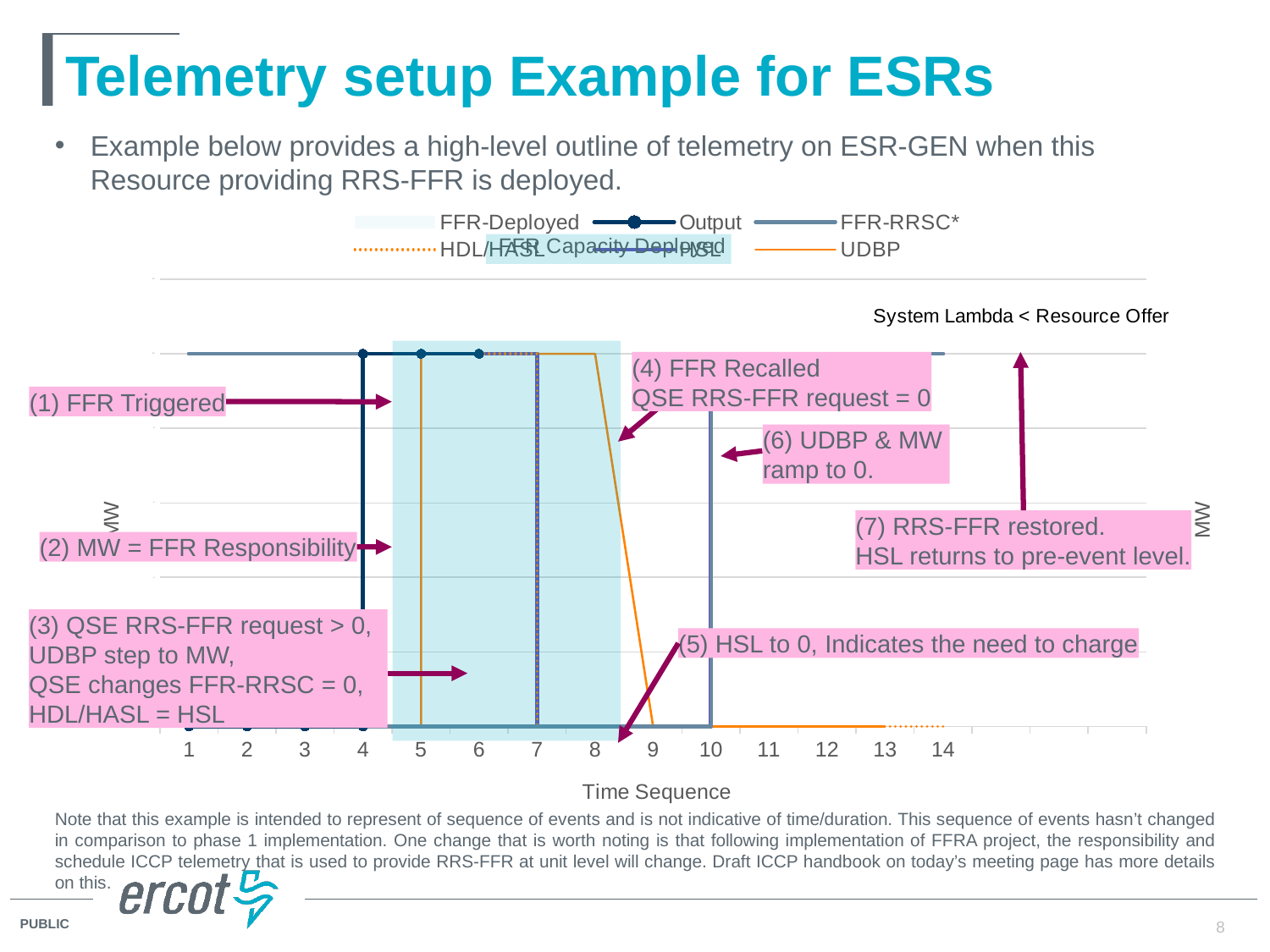
Does the Output series rise or fall at time sequence 4? rise What kind of chart is shown on the slide? combination bar and line chart Does the UDBP series rise or fall between time sequence 8 and time sequence 9? fall What is the label of the x axis? Time Sequence How many time sequence points are labelled on the x axis? 14 Which series in the legend is drawn with a dotted line? HDL/HASL